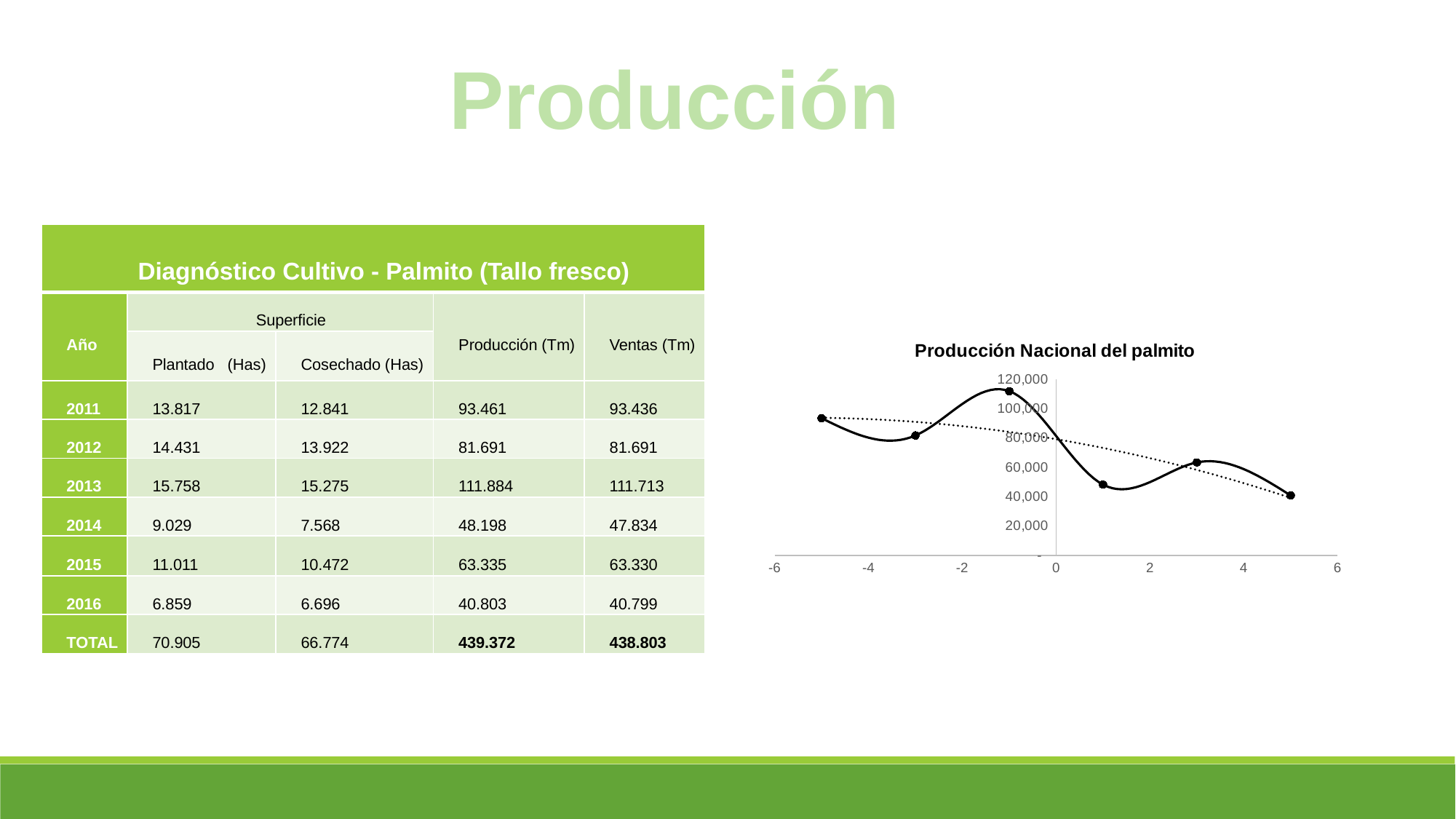
In the 'Producción Nacional del palmito' chart, do the values generally rise or fall from left to right along the x axis? fall In the 'Producción Nacional del palmito' chart, which point is higher: the one at x = -5 or the one at x = 5? x = -5 In the 'Producción Nacional del palmito' chart, at which x value is the highest point? -1 In the 'Producción Nacional del palmito' chart, which point is higher: the one at x = -1 or the one at x = 1? x = -1 In the 'Producción Nacional del palmito' chart, is the value at x = -1 greater or less than 100,000? greater In the 'Producción Nacional del palmito' chart, what style of line is used for the trendline? dotted What kind of chart is 'Producción Nacional del palmito'? line chart How many data points are plotted on the 'Producción Nacional del palmito' chart? 6 What is the title of the chart on the right of the slide? Producción Nacional del palmito In the 'Producción Nacional del palmito' chart, is the value at x = 1 greater or less than 60,000? less In the 'Producción Nacional del palmito' chart, is the value at x = 5 greater or less than 60,000? less